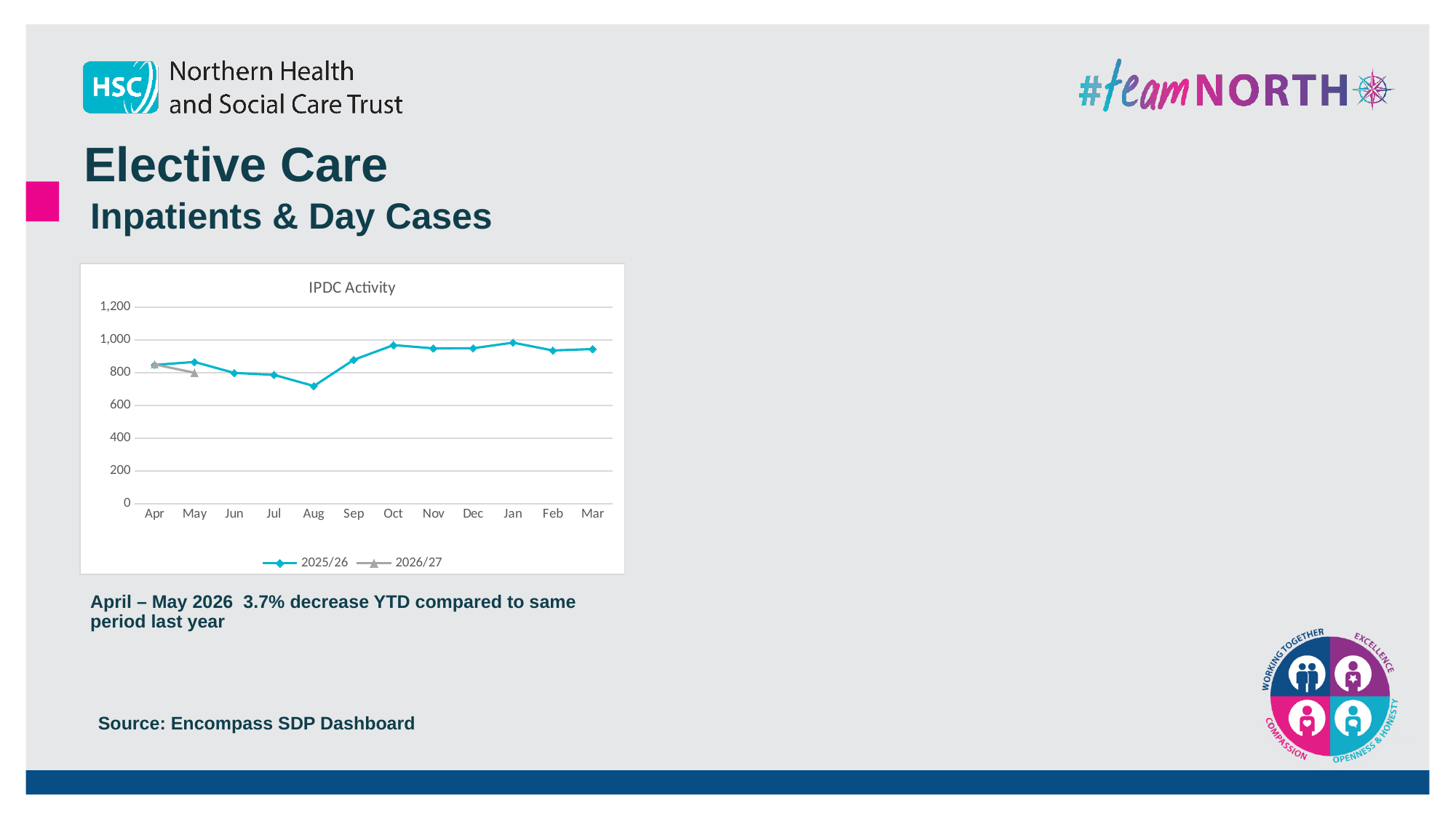
How many months are shown on the x axis of the IPDC Activity chart? 12 Which is larger for the 2025/26 series, the value for Aug or the value for Sep? Sep In which month is the 2025/26 series lowest in the IPDC Activity chart? Aug Does the 2026/27 series rise or fall from Apr to May? fall How many series does the legend of the IPDC Activity chart list? 2 Does the 2025/26 series rise or fall from Aug to Oct? rise What kind of chart is the IPDC Activity chart? line chart Is the 2025/26 value for Oct greater or less than 800? greater Is the 2025/26 value for Aug greater or less than 800? less What is the title of the chart on the slide? IPDC Activity Which series in the IPDC Activity chart is drawn in grey with triangle markers? 2026/27 Is the 2025/26 value for Apr greater or less than 800? greater